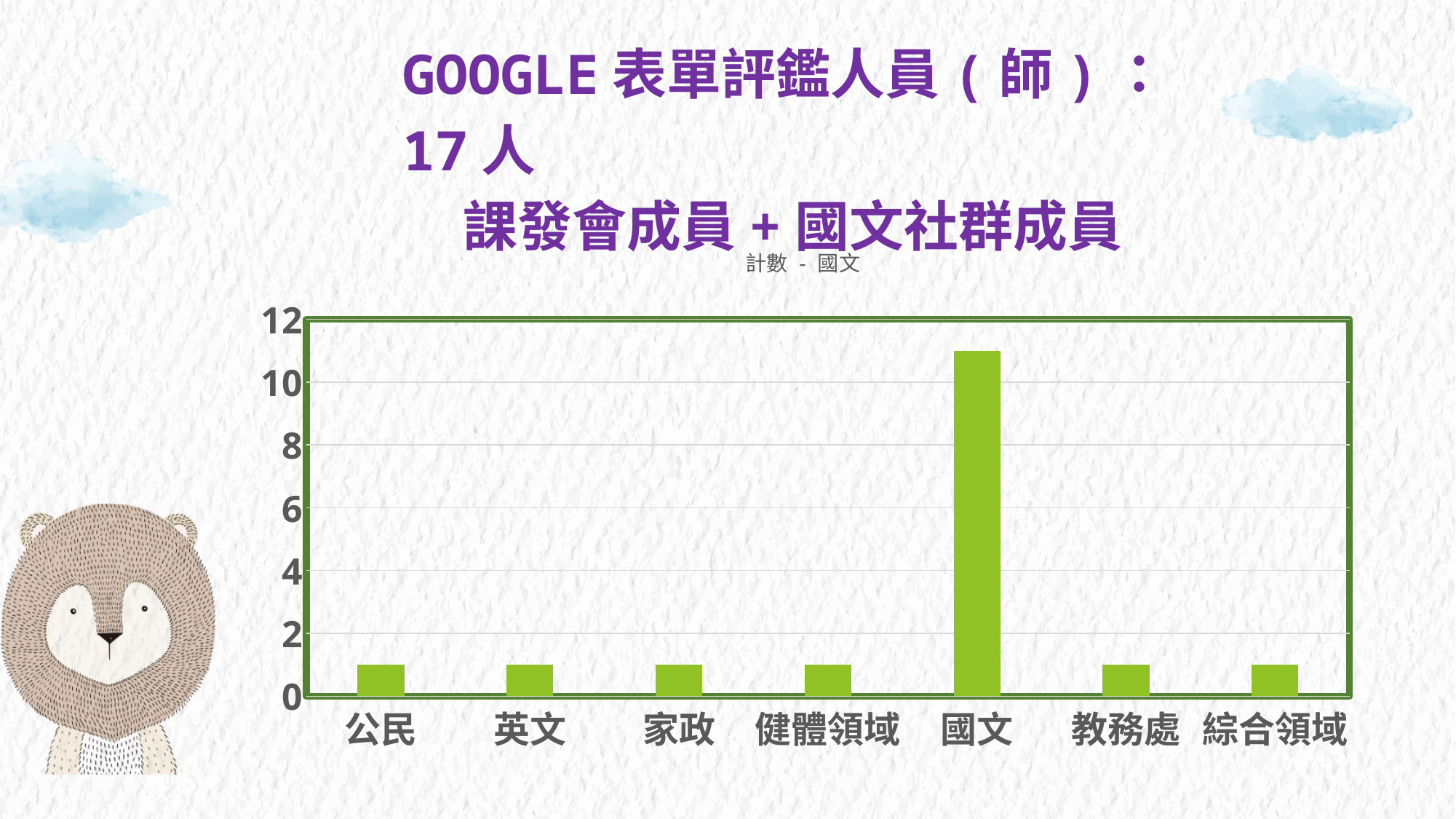
What is the highest value shown on the y axis of the chart? 12 What is the title of the chart? 計數 - 國文 Which is larger, the value for 健體領域 or the value for 國文? 國文 Is the value for 教務處 greater or less than 4? less How many categories are shown on the x axis of the chart? 7 Is the value for 國文 greater or less than 12? less Is the value for 公民 greater or less than 2? less Which is larger, the value for 國文 or the value for 英文? 國文 Which category has the highest bar in the chart? 國文 What colour are the bars in the chart? green What kind of chart is shown on the slide? bar chart